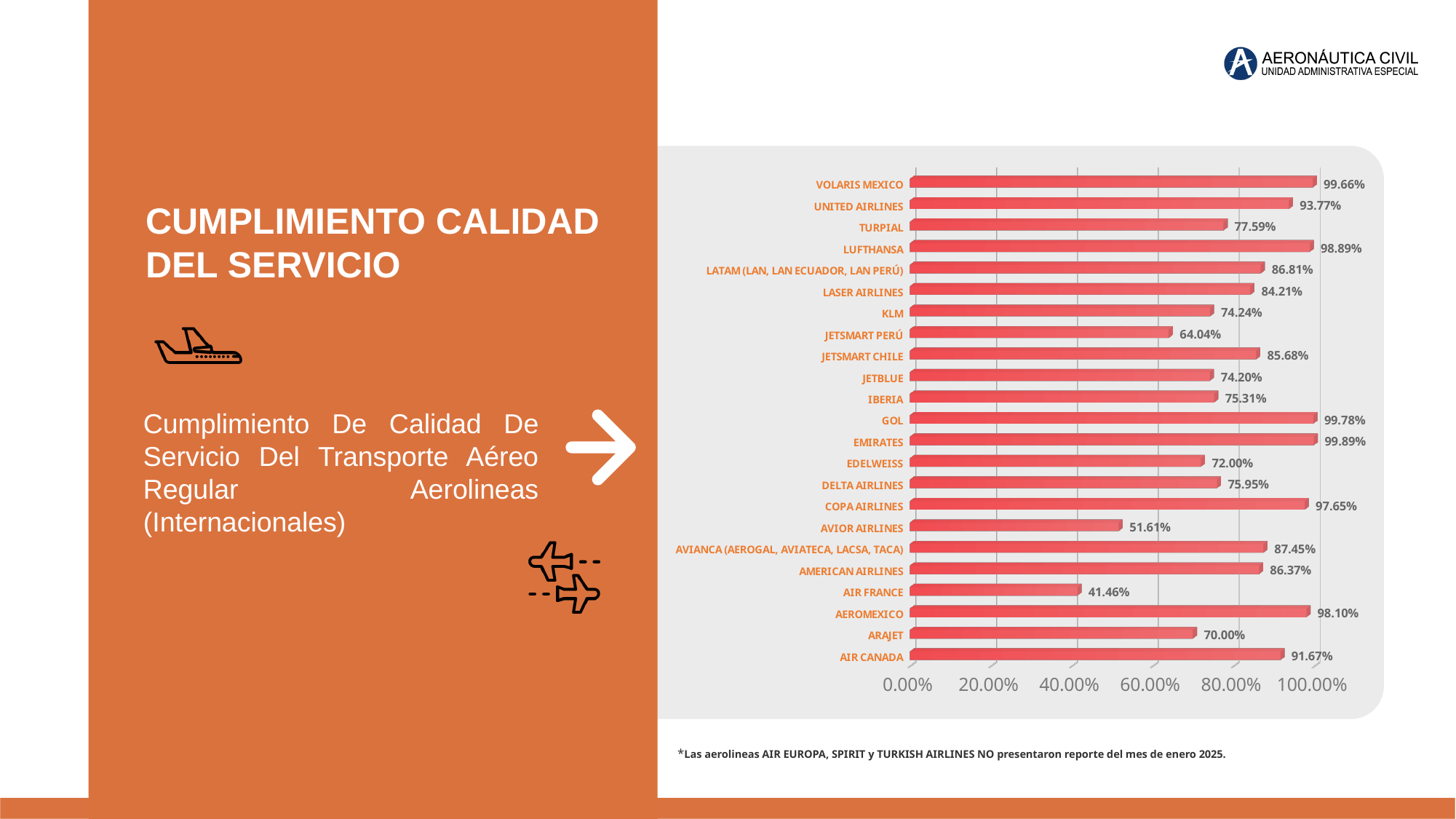
Which airline has the lowest value? AIR FRANCE Which airlines does the footnote say did not submit a report for January 2025? AIR EUROPA, SPIRIT and TURKISH AIRLINES What is the difference between the values for AIR CANADA and ARAJET? 21.67 percentage points How many airlines are shown in the chart? 23 What is the value for COPA AIRLINES? 97.65% Which airline has the highest value? EMIRATES Is the value for AVIOR AIRLINES greater or less than 60.00%? less What kind of chart is shown on the slide? Bar chart What is the value for AIR FRANCE? 41.46% Which is larger, the value for KLM or the value for IBERIA? IBERIA What is the value for JETSMART PERÚ? 64.04% What is the value for ARAJET? 70.00%